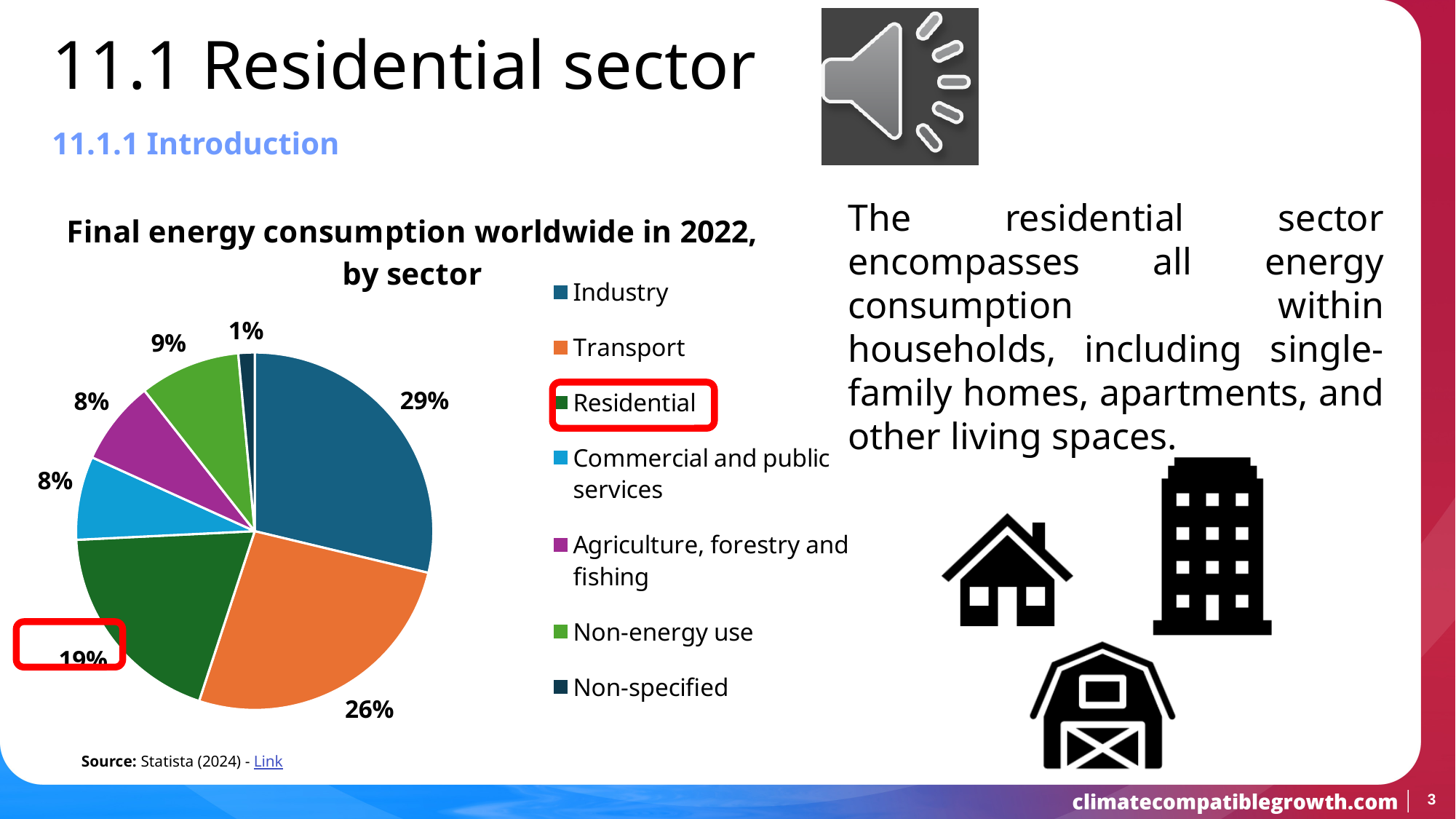
Which sector has the smallest share of final energy consumption? Non-specified Which legend entry is highlighted with a red box? Residential Which sector has a larger share, Transport or Residential? Transport How many sectors are listed in the chart legend? 7 What is the difference in percentage points between the Industry and Residential shares? 10 What share of final energy consumption does the Residential sector account for? 19% What share of final energy consumption does Non-energy use account for? 9% Which sector has the largest share of final energy consumption? Industry What share of final energy consumption does the Transport sector account for? 26% What is the title of the chart? Final energy consumption worldwide in 2022, by sector What share of final energy consumption does the Industry sector account for? 29% What type of chart is shown on the slide? pie chart